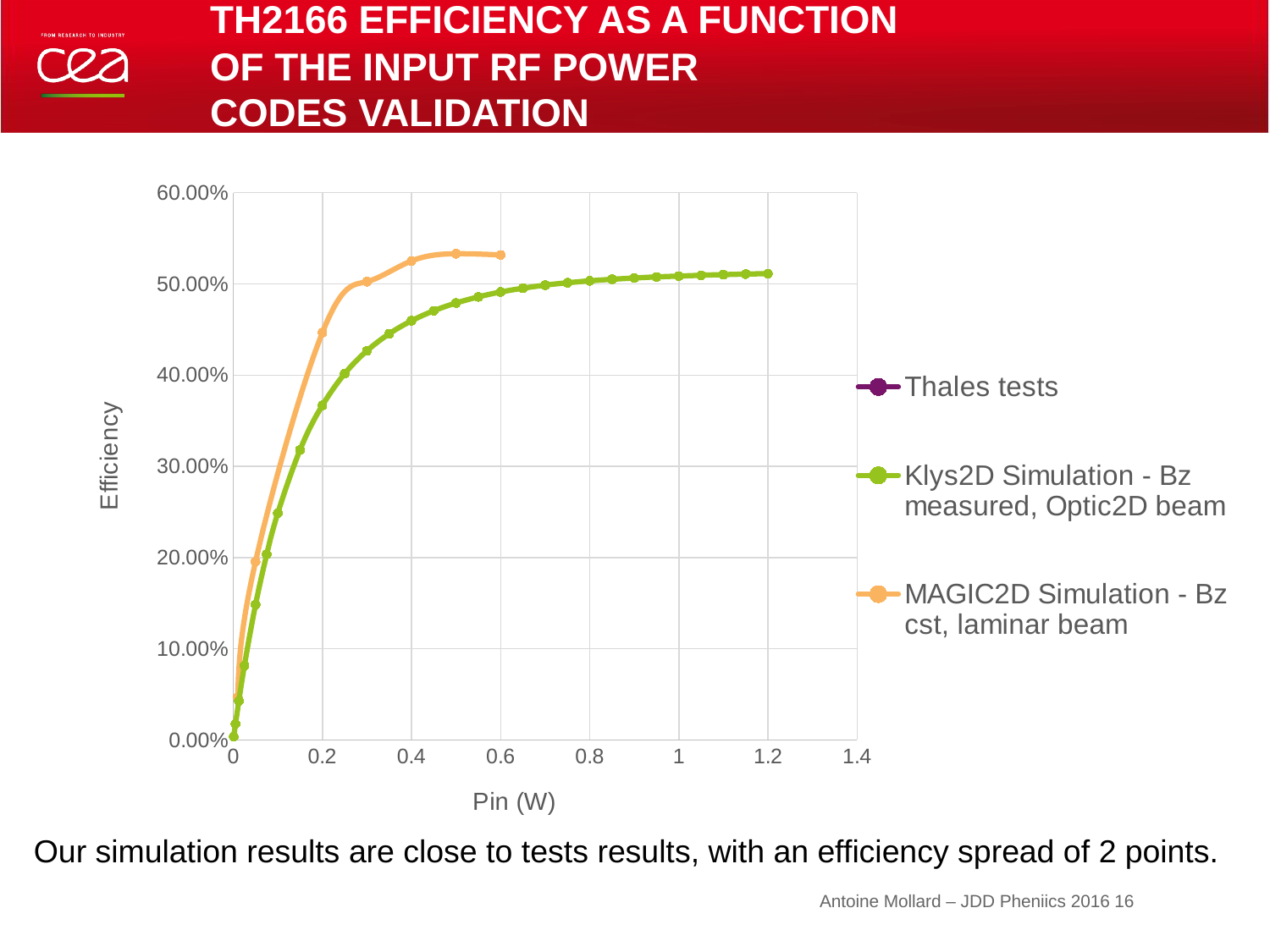
Which plotted series reaches the highest efficiency on the chart? MAGIC2D Simulation - Bz cst, laminar beam Does the efficiency of the Klys2D Simulation series rise or fall as Pin increases? rise What is the label of the x axis? Pin (W) What is the label of the y axis? Efficiency Is the efficiency of the Klys2D Simulation series at Pin = 1.2 W greater or less than 50.00%? greater Is the efficiency of the MAGIC2D Simulation series at Pin = 0.2 W greater or less than 40.00%? greater What kind of chart is shown on the slide? line chart Is the efficiency of the MAGIC2D Simulation series at Pin = 0.6 W greater or less than 50.00%? greater At Pin = 0.2 W, which series has the higher efficiency, Klys2D Simulation or MAGIC2D Simulation? MAGIC2D Simulation How many series does the legend list? 3